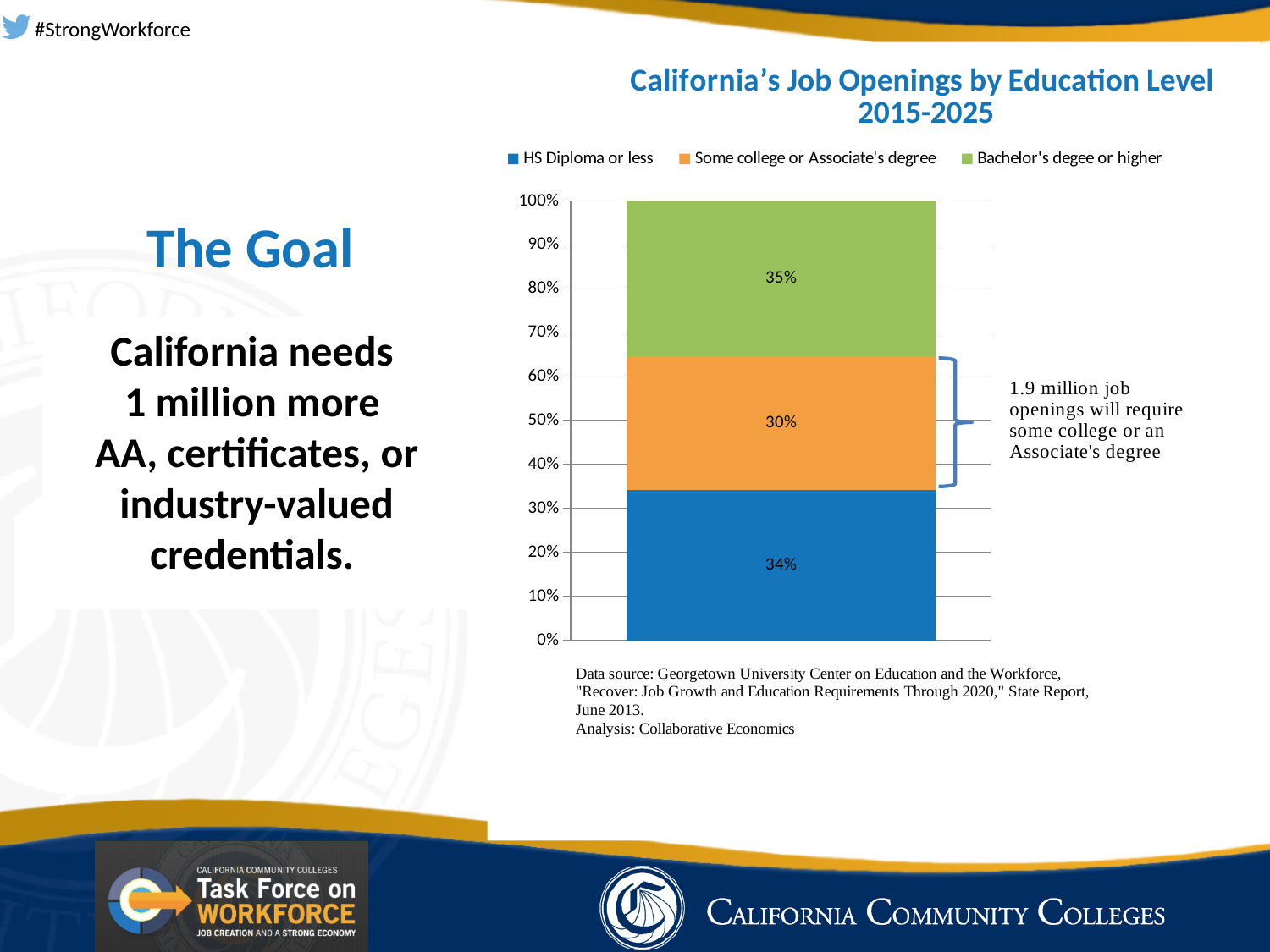
What percentage of job openings require some college or an Associate's degree? 30% What kind of chart is shown on the slide? Stacked bar chart What is the difference in percentage points between the HS Diploma or less share and the Some college or Associate's degree share? 4 percentage points What percentage of job openings require a Bachelor's degree or higher? 35% Which education level accounts for the largest share of job openings? Bachelor's degree or higher What is the difference in percentage points between the Bachelor's degree or higher share and the Some college or Associate's degree share? 5 percentage points What percentage of California's job openings 2015-2025 require a HS Diploma or less? 34% What is the title of the chart? California's Job Openings by Education Level 2015-2025 Which is larger: the share for HS Diploma or less, or the share for Some college or Associate's degree? HS Diploma or less According to the annotation next to the chart, how many job openings will require some college or an Associate's degree? 1.9 million How many series does the chart legend list? 3 Which education level accounts for the smallest share of job openings? Some college or Associate's degree